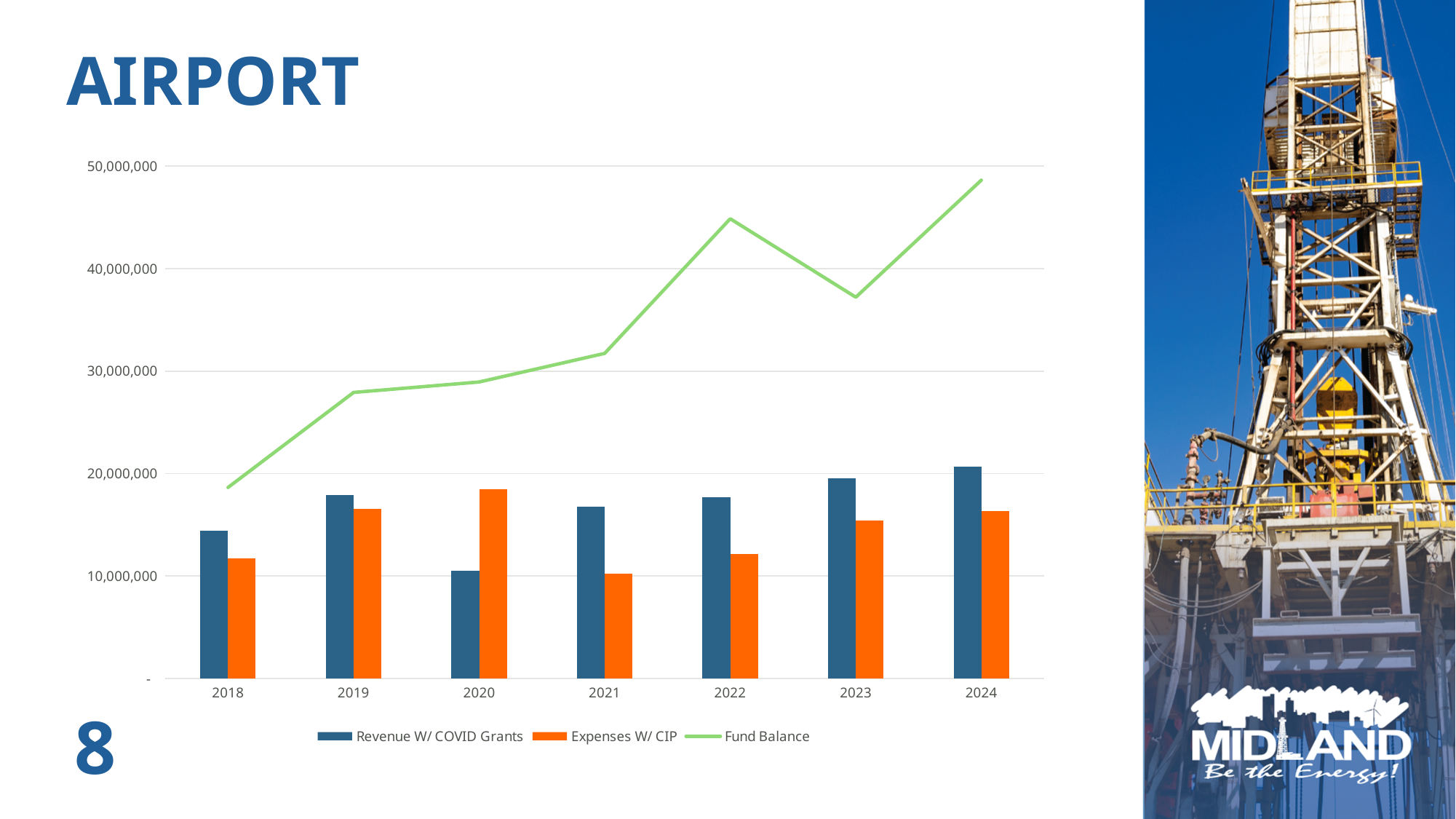
How many years are shown on the x axis? 7 What kind of chart is shown on the slide? A combined bar and line chart In which year is Revenue W/ COVID Grants highest? 2024 Is the Revenue W/ COVID Grants for 2020 greater or less than 20,000,000? less How many series does the legend list? 3 Does the Fund Balance rise or fall from 2018 to 2022? rise Is the Fund Balance for 2022 greater or less than 40,000,000? greater In 2020, which is larger: Revenue W/ COVID Grants or Expenses W/ CIP? Expenses W/ CIP In which year is Revenue W/ COVID Grants lowest? 2020 In which year is Expenses W/ CIP lowest? 2021 In which year is Expenses W/ CIP highest? 2020 In which year does the Fund Balance reach its highest point? 2024